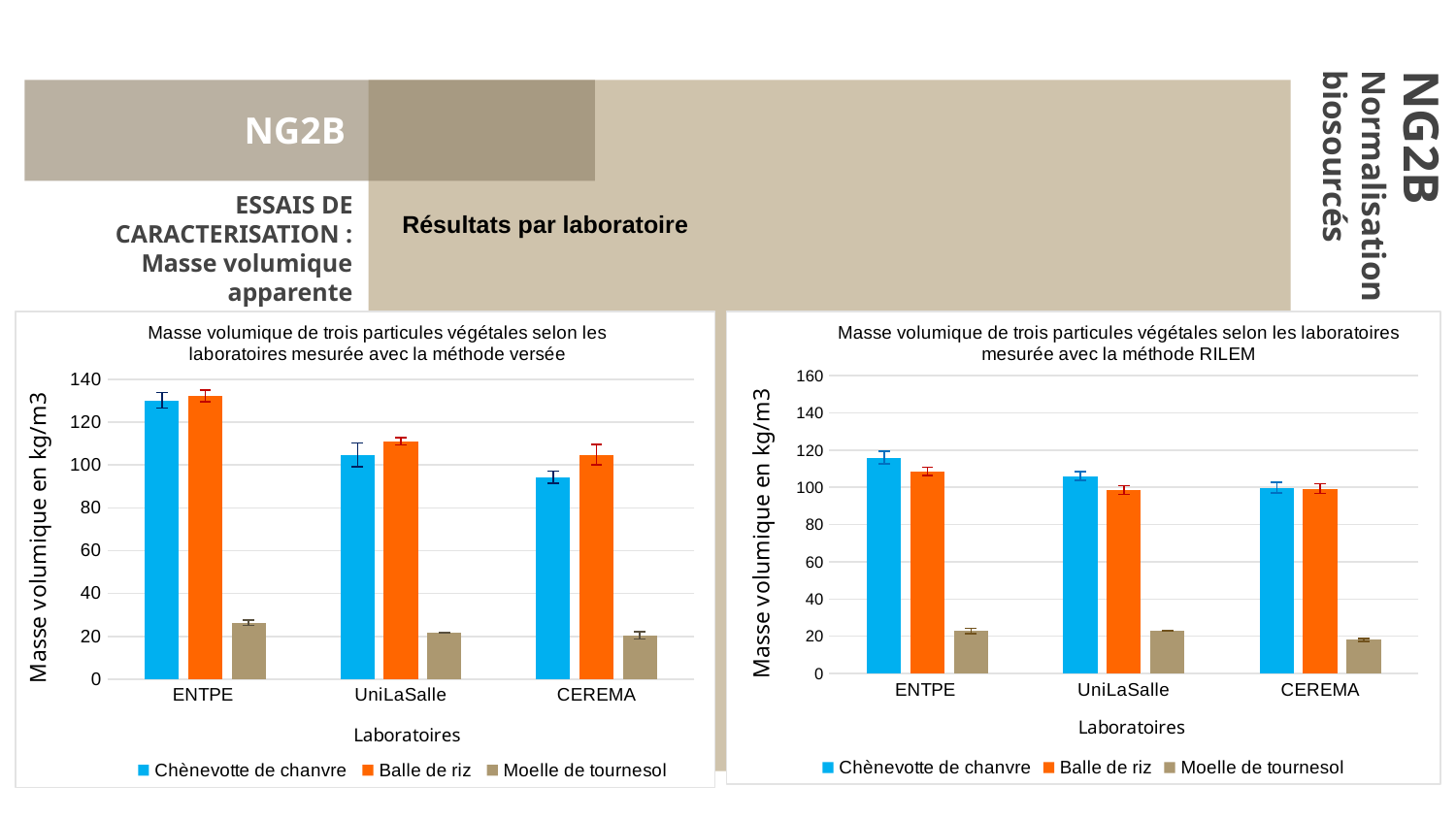
In the left chart (méthode versée), how many series does the legend list? 3 In the left chart (méthode versée), what kind of chart is shown? bar chart In the right chart (méthode RILEM), which is larger at ENTPE, Chènevotte de chanvre or Balle de riz? Chènevotte de chanvre In the right chart (méthode RILEM), what is the maximum value shown on the y axis? 160 In the left chart (méthode versée), which series has the lowest value at ENTPE? Moelle de tournesol In the right chart (méthode RILEM), is the value for Moelle de tournesol at CEREMA greater or less than 40? less In the left chart (méthode versée), is the value for Chènevotte de chanvre at CEREMA greater or less than 100? less In the left chart (méthode versée), which laboratory has the highest value for Balle de riz? ENTPE In the left chart (méthode versée), how many laboratories are shown on the x axis? 3 In the left chart (méthode versée), does the value for Chènevotte de chanvre rise or fall from ENTPE to CEREMA? fall In the left chart (méthode versée), is the value for Balle de riz at ENTPE greater or less than 120? greater